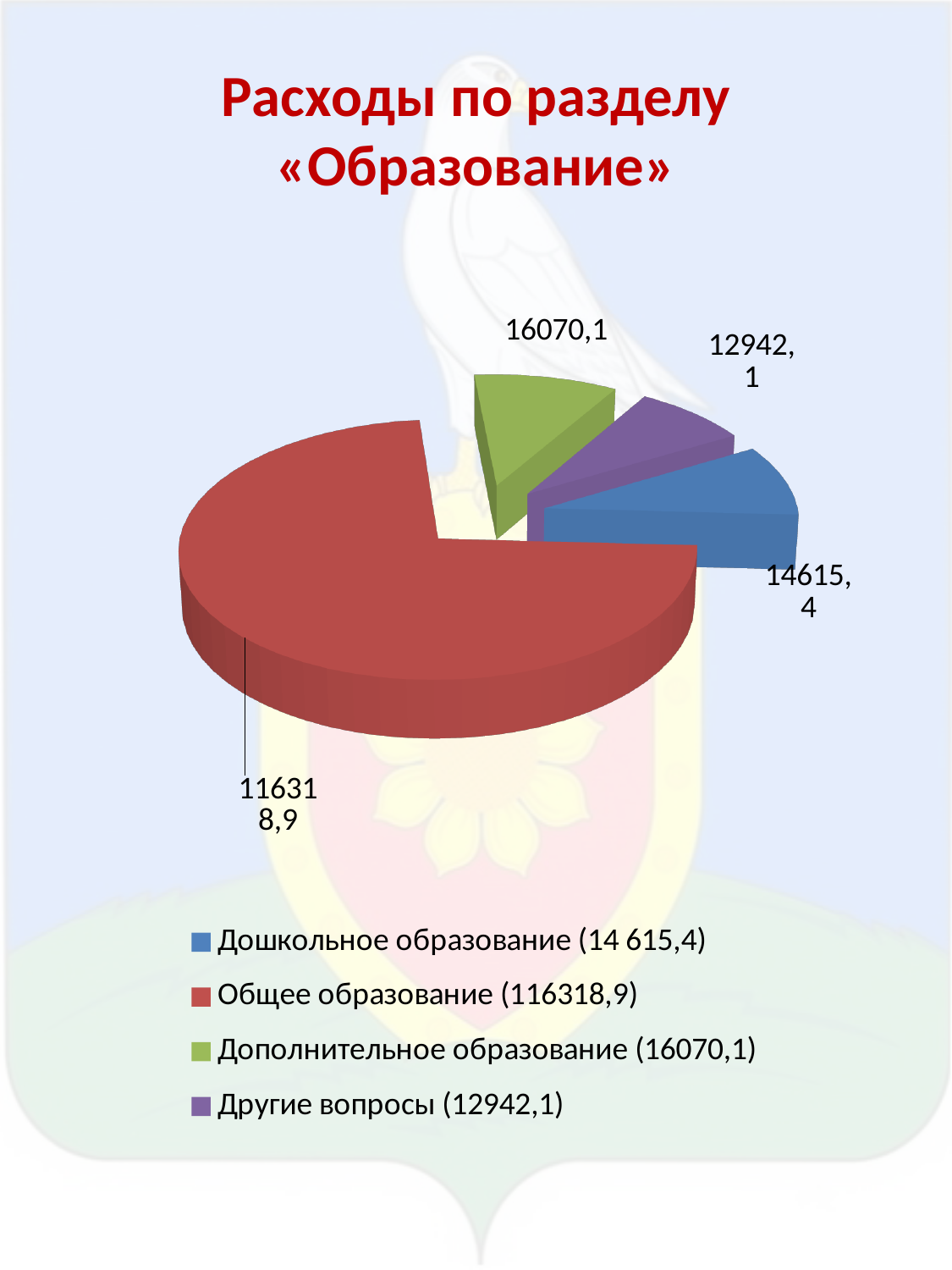
What is the value for Общее образование? 116318,9 What is the difference between Дополнительное образование and Другие вопросы? 3128 Which category has the smallest slice of the pie? Другие вопросы Which is larger: Дополнительное образование or Дошкольное образование? Дополнительное образование What is the difference between Дошкольное образование and Другие вопросы? 1673,3 What is the value for Дошкольное образование? 14615,4 What is the value for Другие вопросы? 12942,1 How many categories does the pie chart have? 4 What kind of chart is shown on the slide? pie chart What is the value for Дополнительное образование? 16070,1 Which category has the largest slice of the pie? Общее образование What is the title of the slide? Расходы по разделу «Образование»